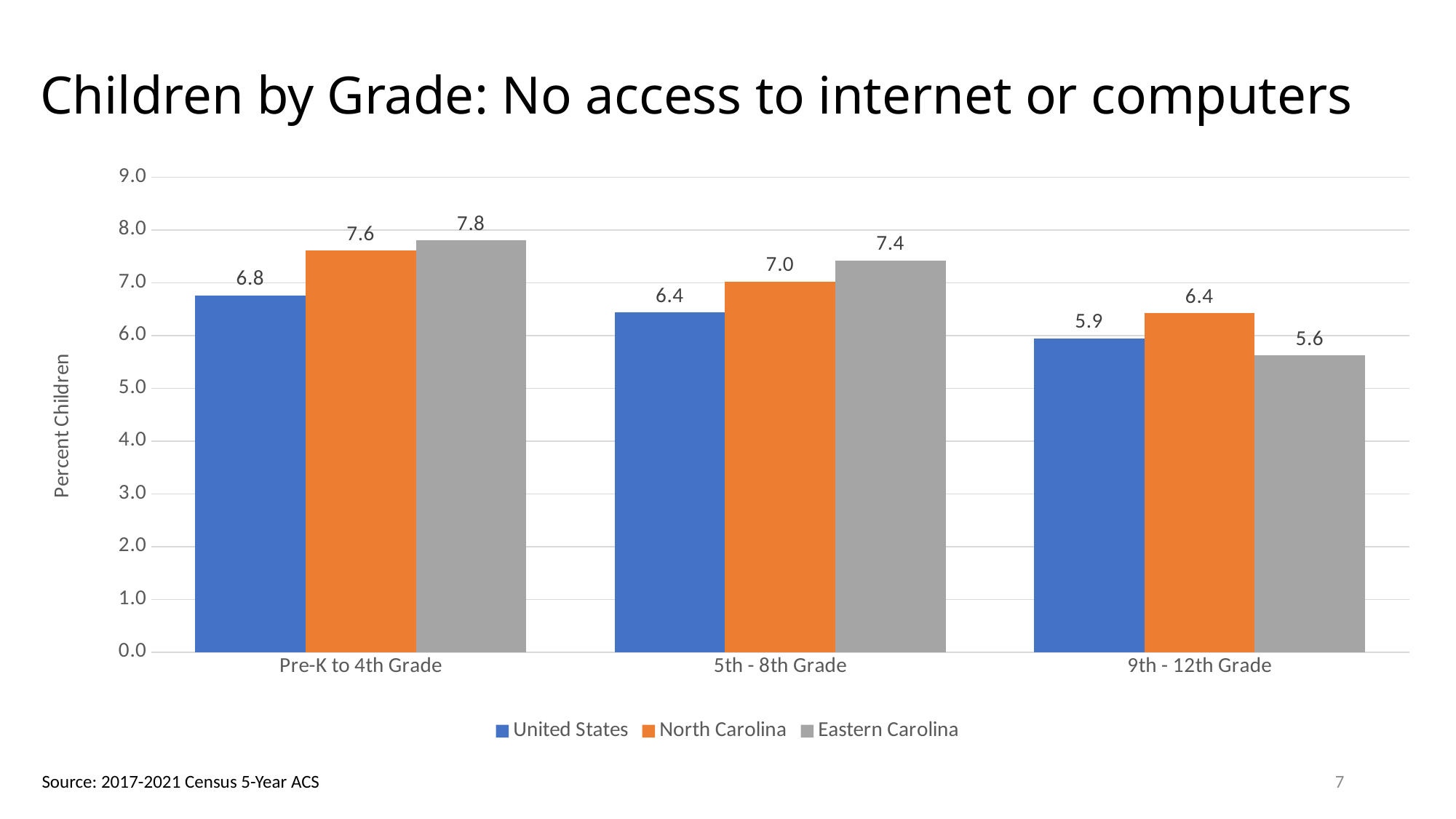
In the 9th - 12th Grade category, which is larger: North Carolina or Eastern Carolina? North Carolina How many grade categories are shown on the x axis? 3 Do the United States values rise or fall from Pre-K to 4th Grade to 9th - 12th Grade? Fall What is the difference between the Eastern Carolina and United States values in the Pre-K to 4th Grade category? 1.0 What is the value for the United States in the 5th - 8th Grade category? 6.4 What is the value for North Carolina in the Pre-K to 4th Grade category? 7.6 Is the value for Eastern Carolina in the 5th - 8th Grade category greater or less than 7.0? greater Which grade category has the lowest value for the United States? 9th - 12th Grade What kind of chart is shown on the slide? Bar chart Which grade category has the highest value for Eastern Carolina? Pre-K to 4th Grade How many series does the legend list? 3 What is the value for Eastern Carolina in the 9th - 12th Grade category? 5.6